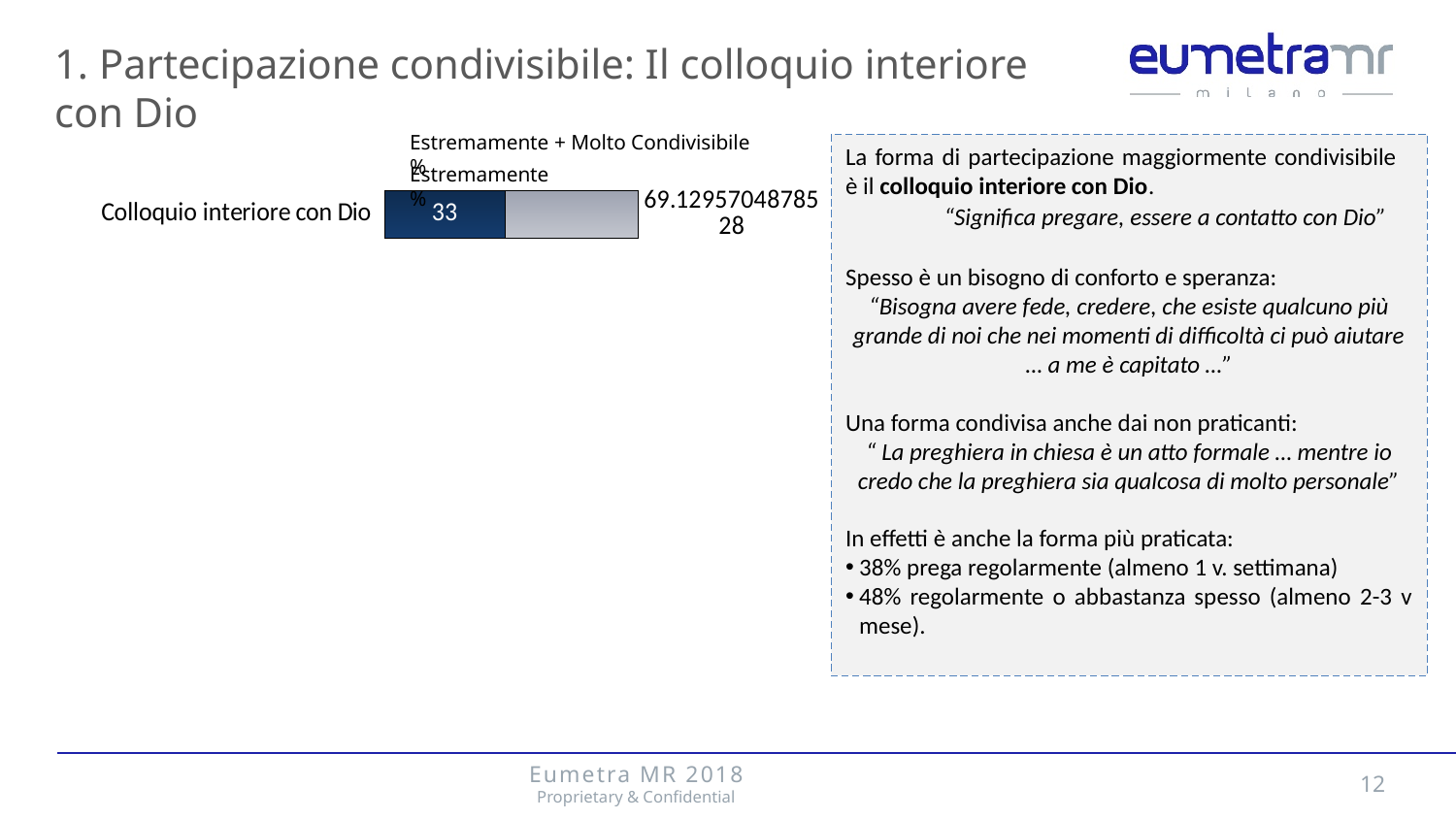
Which legend entry corresponds to the dark blue segment of the bar? Estremamente % What kind of chart is shown on the slide? bar chart Is the value printed at the end of the bar for Colloquio interiore con Dio greater or less than 60? greater Which is larger for Colloquio interiore con Dio: the 'Estremamente %' value or the value printed at the end of the bar? the value printed at the end of the bar How many series does the chart's legend list? 2 What is the name of the category shown in the chart? Colloquio interiore con Dio What value is printed at the right end of the bar for Colloquio interiore con Dio? 69.1295704878528 Is the 'Estremamente %' value for Colloquio interiore con Dio greater or less than 50? less What is the value of the dark blue 'Estremamente %' segment for Colloquio interiore con Dio? 33 How many categories does the chart show? 1